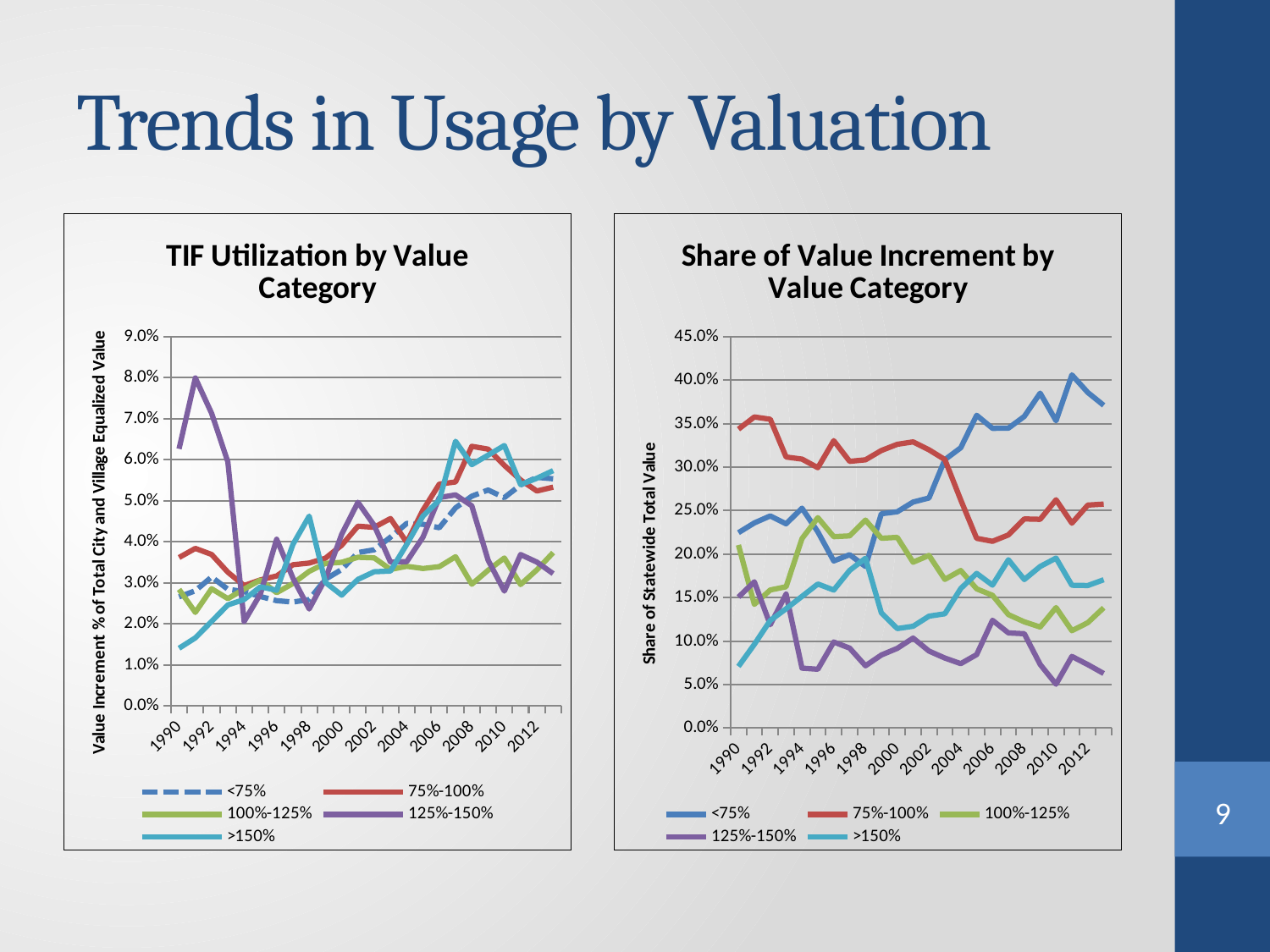
In the 'Share of Value Increment by Value Category' chart, does the <75% series generally rise or fall from 1990 to 2013? rise In the 'Share of Value Increment by Value Category' chart, is the value for 75%-100% in 1990 greater or less than 30.0%? greater How many series does the legend of the 'Share of Value Increment by Value Category' chart list? 5 In the 'TIF Utilization by Value Category' chart, is the value for >150% in 1990 greater or less than 2.0%? less In the 'Share of Value Increment by Value Category' chart, which series has the lowest share in 2013? 125%-150% In the 'Share of Value Increment by Value Category' chart, which series has the highest share in 2013? <75% In the 'TIF Utilization by Value Category' chart, which series has the highest value in 1991? 125%-150% What kind of chart is the 'TIF Utilization by Value Category' chart? line chart In the 'Share of Value Increment by Value Category' chart, does the 75%-100% series generally rise or fall from 1990 to 2013? fall In the 'Share of Value Increment by Value Category' chart, is the value for 125%-150% in 1990 greater or less than 20.0%? less What is the y-axis label of the 'Share of Value Increment by Value Category' chart? Share of Statewide Total Value In the 'Share of Value Increment by Value Category' chart, which is larger in 2013, <75% or >150%? <75%